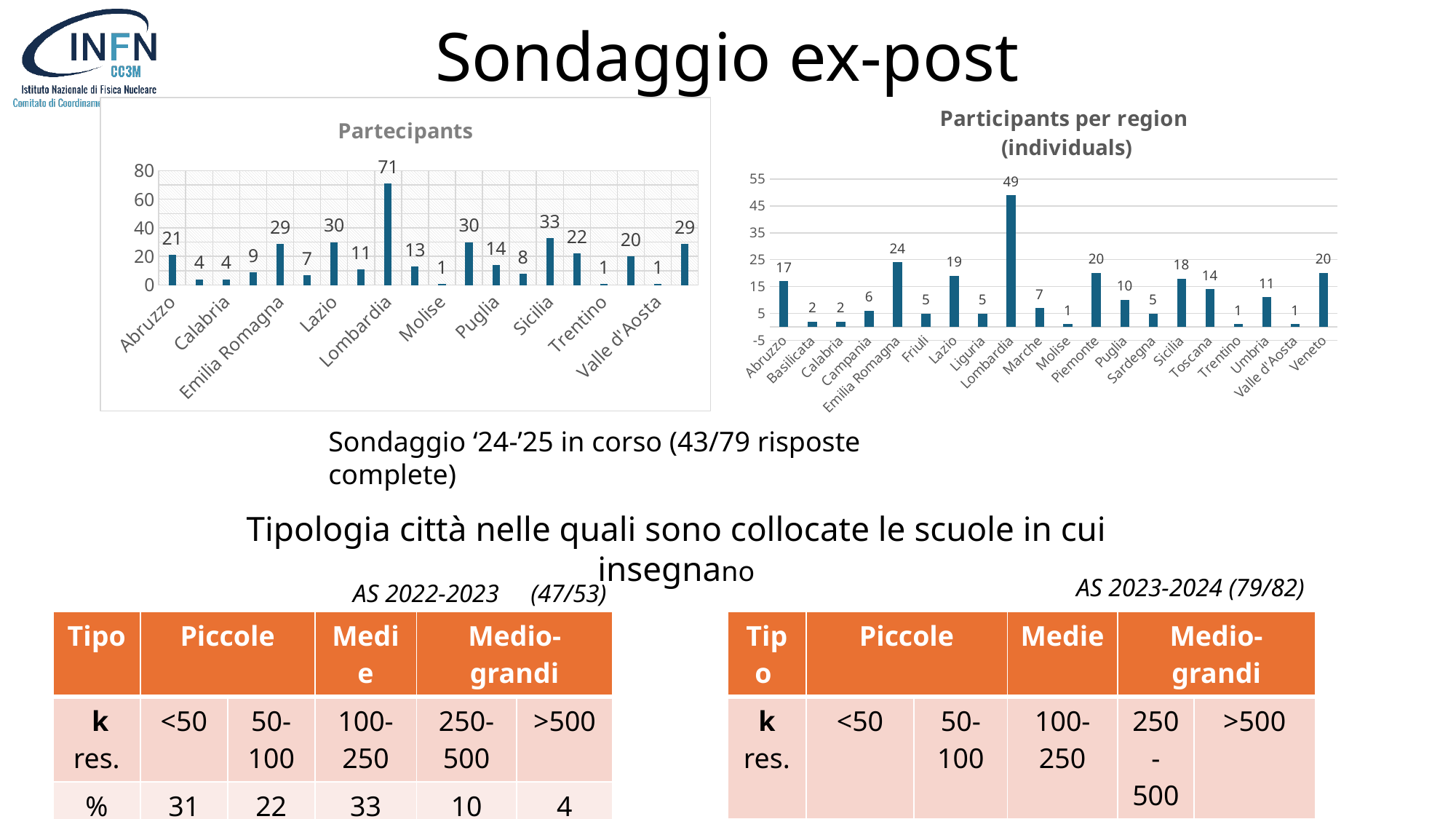
In the 'Participants per region (individuals)' chart, what is the value for Emilia Romagna? 24 In the 'Partecipants' chart, which is larger, Abruzzo or Lazio? Lazio What type of chart is the 'Partecipants' chart? Bar chart In the 'Participants per region (individuals)' chart, which region has the highest value? Lombardia In the 'Participants per region (individuals)' chart, what is the value for Lombardia? 49 In the 'Participants per region (individuals)' chart, what is the value for Veneto? 20 In the 'Participants per region (individuals)' chart, what is the difference between Piemonte and Puglia? 10 In the 'Partecipants' chart, what is the value for Sicilia? 33 In the 'Partecipants' chart, what is the difference between Lombardia and Emilia Romagna? 42 In the 'Participants per region (individuals)' chart, how many regions are shown on the x axis? 20 In the 'Participants per region (individuals)' chart, which is larger, Sicilia or Toscana? Sicilia In the 'Partecipants' chart, what is the value for Lombardia? 71